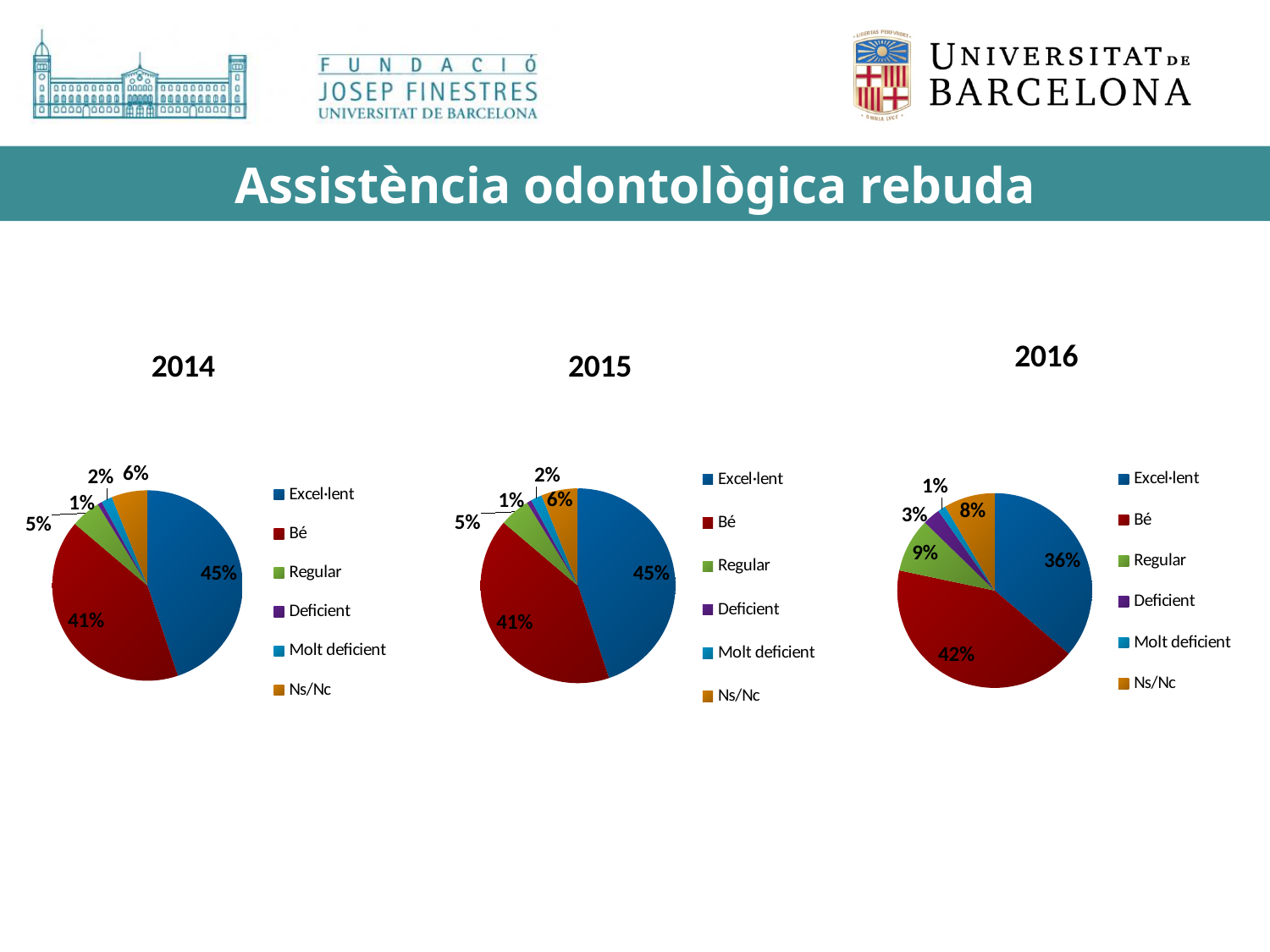
In the 2014 chart, what percentage is labelled for Bé? 41% In the 2014 chart, which category has the smallest slice? Deficient In the 2016 chart, what percentage is shown for Bé? 42% In the 2015 chart, what percentage is shown for Ns/Nc? 6% In the 2015 chart, what is the difference between the Excel·lent and Bé percentages? 4% What type of chart is used for the 2015 data? Pie chart In the 2016 chart, which is larger, Regular or Ns/Nc? Regular In the 2014 chart, which category has the largest slice? Excel·lent In the 2016 chart, what is the difference between the Bé and Excel·lent percentages? 6% How many categories does the legend of the 2016 chart list? 6 In the 2016 chart, which category has the largest slice? Bé In the 2014 chart, what share of the pie is Excel·lent? 45%